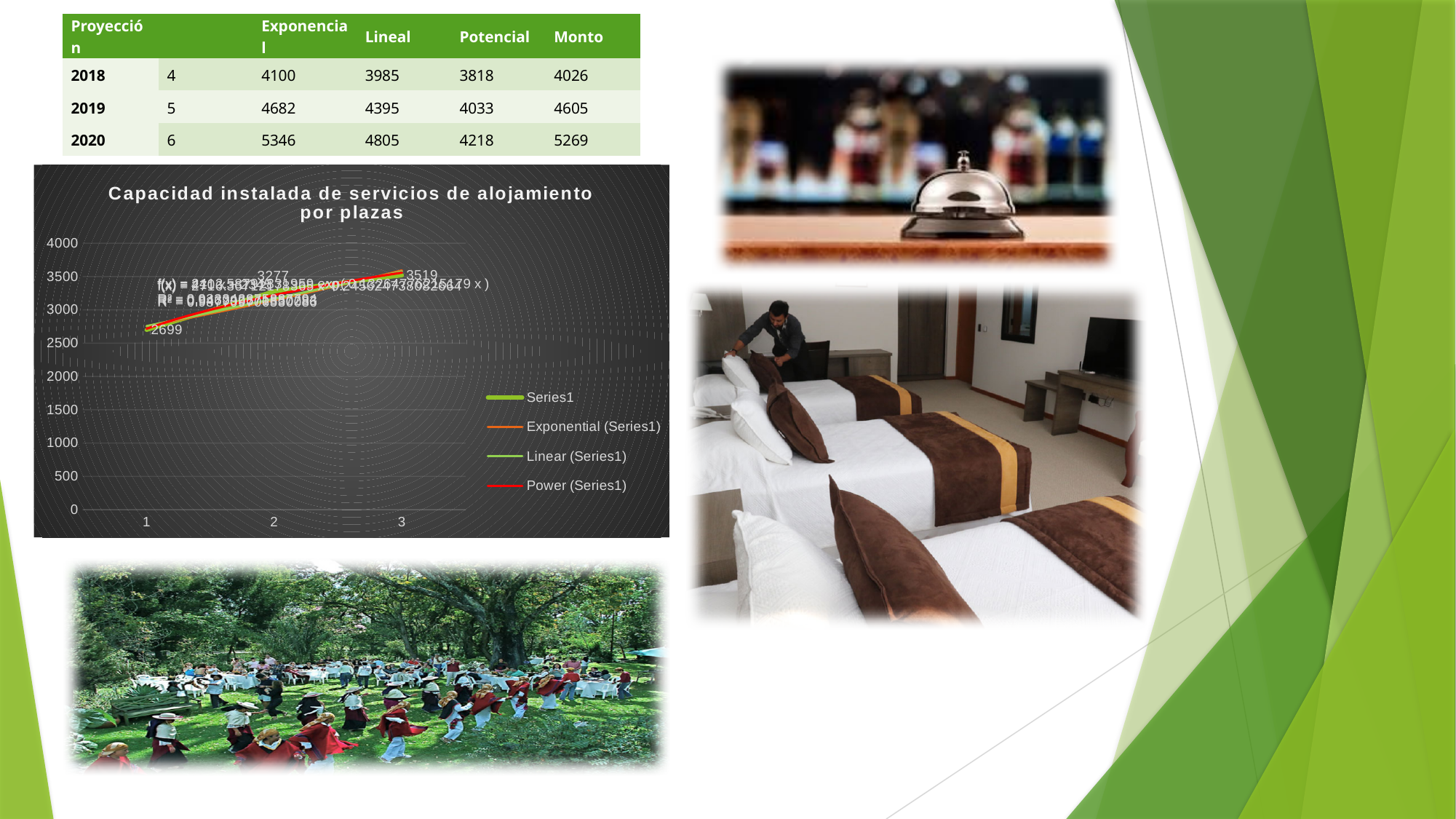
What type of chart is shown on the slide? line chart At which x value does Series1 have its lowest value? 1 At which x value does Series1 reach its highest value? 3 What is the difference between the Series1 values at x = 3 and x = 1? 820 What is the title of the chart? Capacidad instalada de servicios de alojamiento por plazas What is the value of Series1 at x = 1? 2699 Which is larger, the Series1 value at x = 2 or at x = 3? x = 3 What is the value of Series1 at x = 2? 3277 What is the difference between the Series1 values at x = 2 and x = 1? 578 How many entries does the legend list? 4 How many data points are plotted for Series1? 3 What is the value of Series1 at x = 3? 3519